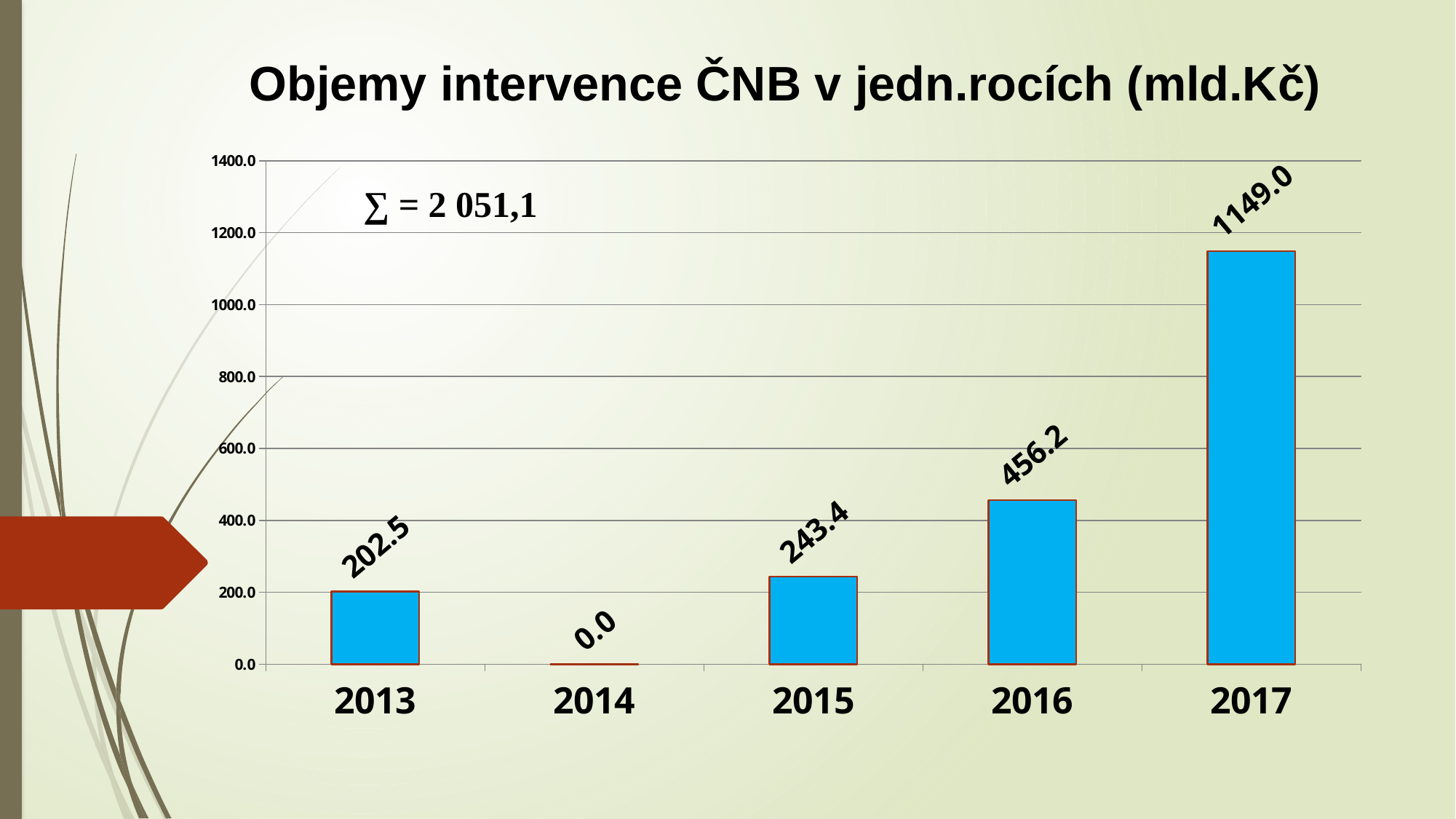
What is the difference between the values for 2017 and 2016? 692.8 What is the value for 2017? 1149.0 Which year has the highest value? 2017 How many years are shown on the x axis? 5 What is the value for 2015? 243.4 Which year has the lowest value? 2014 What is the value for 2013? 202.5 Which is larger, the value for 2016 or the value for 2015? 2016 What is the title of the chart? Objemy intervence ČNB v jedn.rocích (mld.Kč) What kind of chart is shown on the slide? bar chart What is the value for 2014? 0.0 What is the difference between the values for 2015 and 2013? 40.9